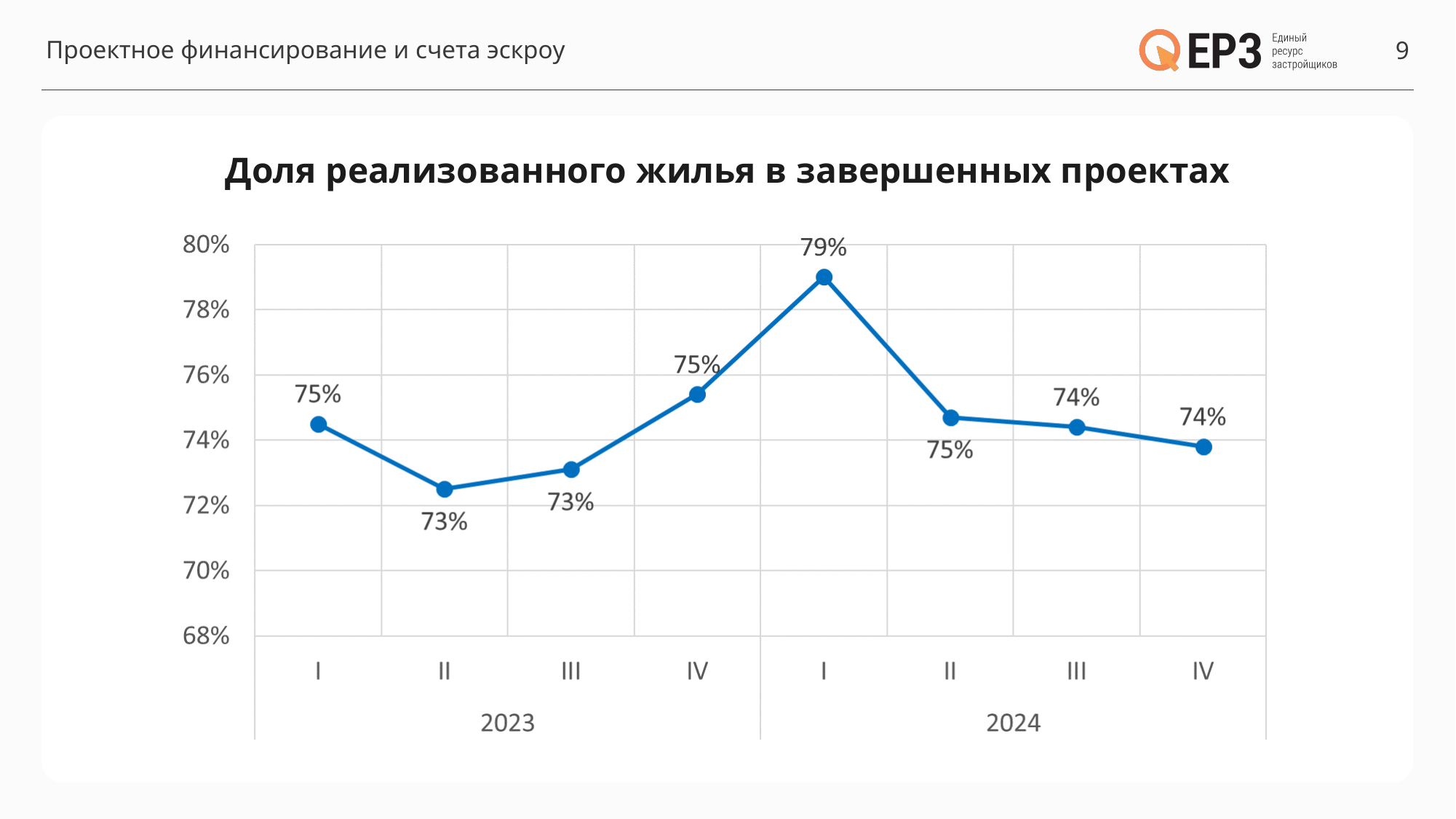
Is the value for quarter I of 2024 greater or less than 78%? greater What type of chart is shown on the slide? line chart Which quarter has the highest value? I 2024 What is the value for quarter II of 2023? 73% Which is larger: the value for quarter I of 2024 or quarter III of 2024? I 2024 What is the value for quarter I of 2024? 79% What is the difference between the value for quarter I of 2024 and quarter II of 2023? 6 percentage points How many data points are plotted on the chart? 8 What is the title of the chart? Доля реализованного жилья в завершенных проектах Does the value rise or fall from quarter IV of 2023 to quarter I of 2024? rise What is the value for quarter IV of 2023? 75% What is the value for quarter IV of 2024? 74%